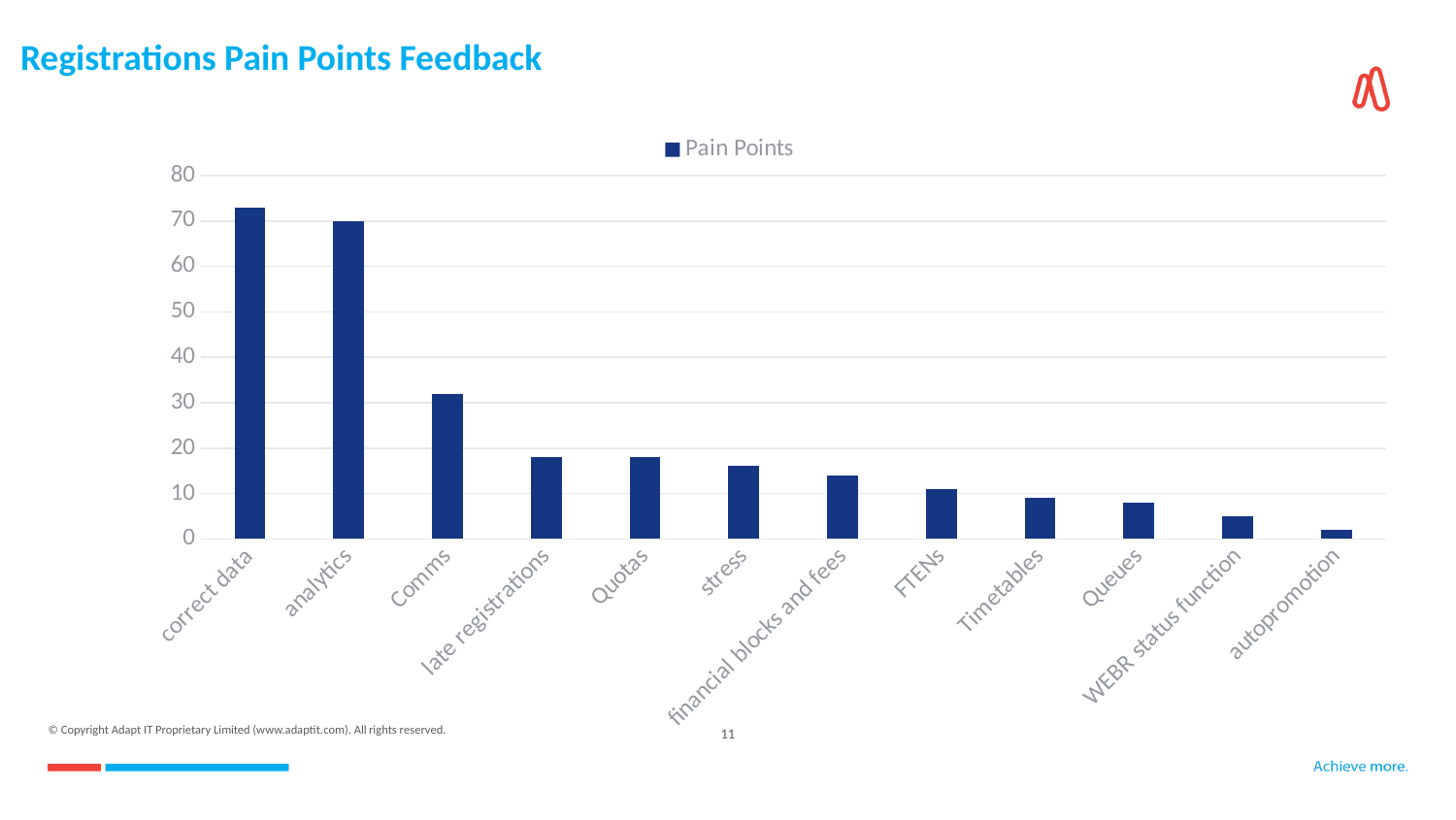
Is the value for WEBR status function greater or less than 10? less How many categories are plotted along the x axis? 12 Which category has the highest value? correct data What series name is shown in the chart legend? Pain Points Is the value for stress greater or less than 20? less Do the values rise or fall moving from left to right along the x axis? fall What kind of chart is shown on the slide? bar chart Which category has the lowest value? autopromotion How many series does the legend list? 1 Is the value for analytics greater or less than 60? greater Which is larger, the value for Comms or the value for late registrations? Comms